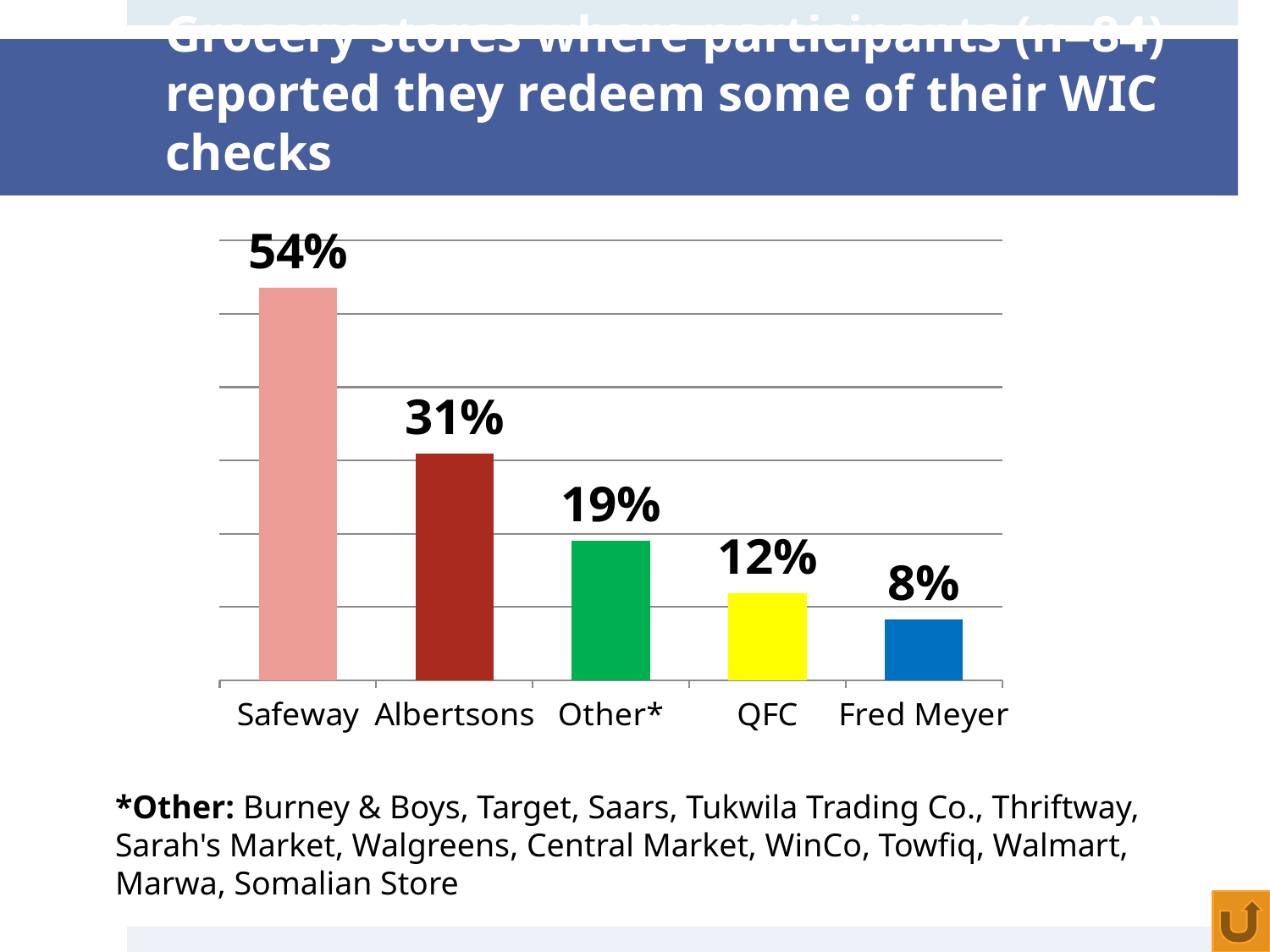
Which has a larger percentage, Albertsons or Other*? Albertsons Which grocery store has the highest percentage? Safeway What is the difference between the percentages for Other* and QFC? 7% Which grocery store has the lowest percentage? Fred Meyer What percentage of participants reported redeeming WIC checks at Albertsons? 31% How many grocery store categories are shown in the chart? 5 Do the values rise or fall from left to right across the categories? Fall What type of chart is shown on the slide? Bar chart What is the value shown for QFC? 12% What is the difference between the percentages for Safeway and Albertsons? 23% What is the value shown for Fred Meyer? 8% What percentage of participants reported redeeming WIC checks at Safeway? 54%